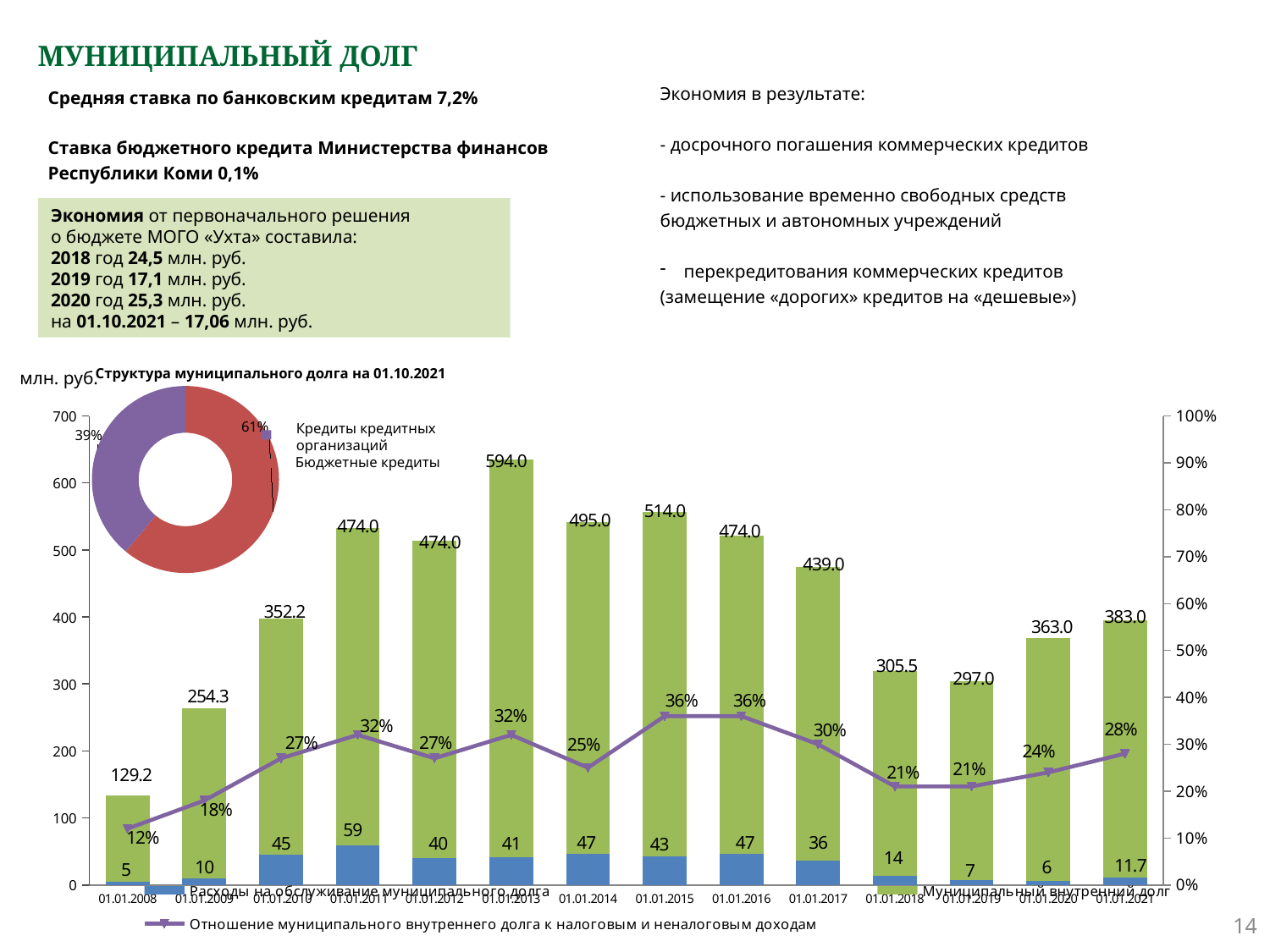
In the bar chart, what is the value of Расходы на обслуживание муниципального долга on 01.01.2011? 59 In the bar chart, which is larger: Муниципальный внутренний долг on 01.01.2015 or on 01.01.2014? 01.01.2015 How many dates are shown on the x axis of the bar chart? 14 In the donut chart Структура муниципального долга на 01.10.2021, what share is Кредиты кредитных организаций? 39% In the bar chart, does Муниципальный внутренний долг rise or fall from 01.01.2018 to 01.01.2021? rise What kind of chart is Структура муниципального долга на 01.10.2021? donut chart In the bar chart, what is the difference in Муниципальный внутренний долг between 01.01.2021 and 01.01.2020? 20.0 In the bar chart, what is the value of Муниципальный внутренний долг on 01.01.2013? 594.0 How many series does the legend of the bar chart list? 3 In the bar chart, what is the value of Отношение муниципального внутреннего долга к налоговым и неналоговым доходам on 01.01.2021? 28% In the bar chart, on which date is Муниципальный внутренний долг highest? 01.01.2013 In the bar chart, on which date is Муниципальный внутренний долг lowest? 01.01.2008